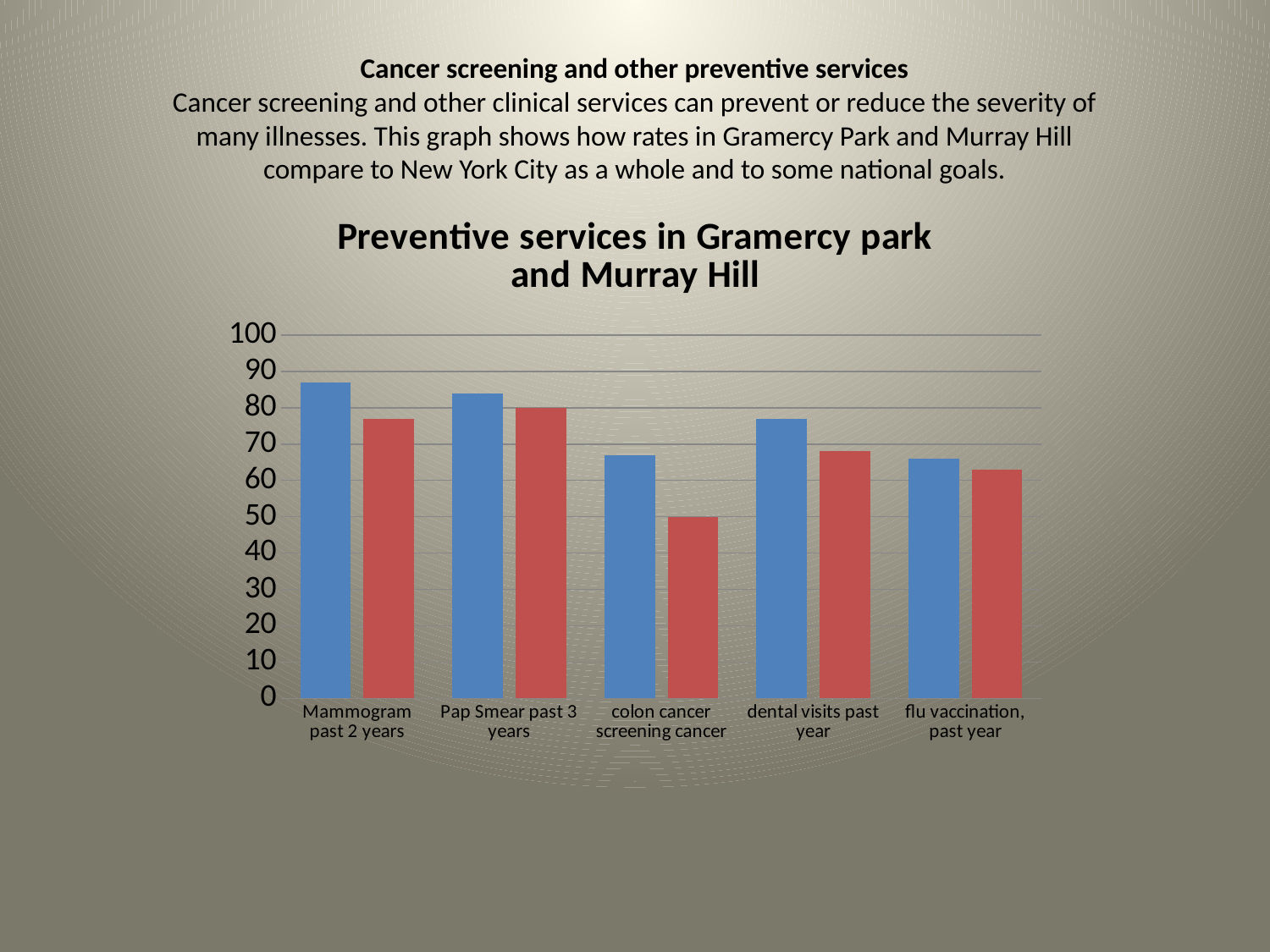
Is the red bar for dental visits past year greater or less than 70? less Which category has the tallest blue bar? Mammogram past 2 years Is the blue bar for Mammogram past 2 years greater or less than 80? greater Is the blue bar for flu vaccination, past year greater or less than 70? less For colon cancer screening cancer, which bar is larger, the blue bar or the red bar? the blue bar For dental visits past year, which bar is larger, the blue bar or the red bar? the blue bar How many categories are shown on the x axis of the chart? 5 What is the title of the chart? Preventive services in Gramercy park and Murray Hill What kind of chart is shown on the slide? bar chart Which category has the shortest red bar? colon cancer screening cancer